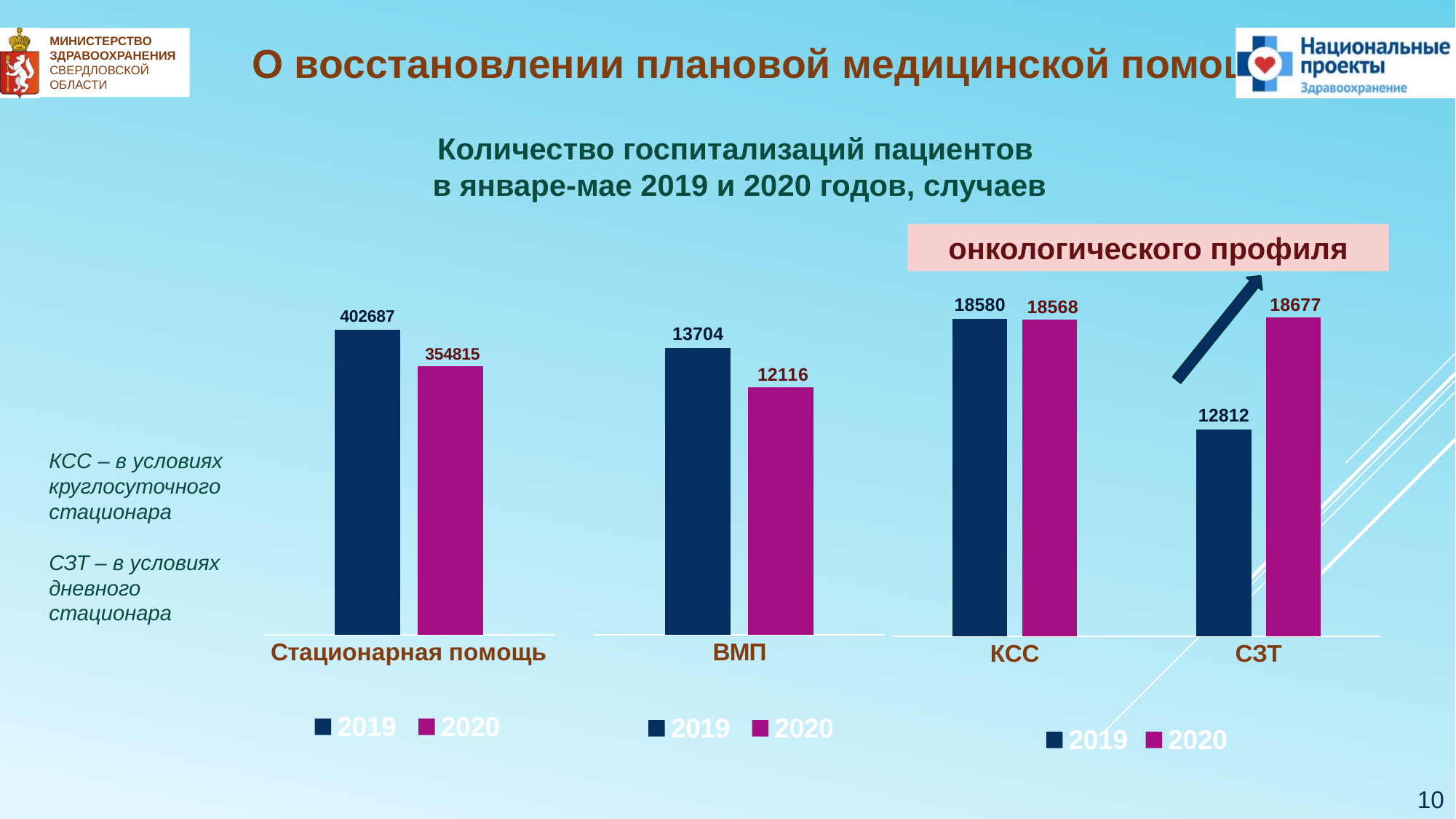
What type of chart is the middle chart (ВМП)? Bar chart In the left chart (Стационарная помощь), what is the value for 2019? 402687 In the middle chart (ВМП), what is the value for 2020? 12116 How many series does the legend of the right chart (онкологического профиля) list? 2 In the left chart (Стационарная помощь), what is the value for 2020? 354815 In the middle chart (ВМП), which year has the larger value, 2019 or 2020? 2019 In the middle chart (ВМП), what is the difference between the 2019 and 2020 values? 1588 In the right chart (онкологического профиля), what is the value for КСС in 2019? 18580 In the right chart (онкологического профиля), what is the difference between the 2020 and 2019 values for СЗТ? 5865 In the left chart (Стационарная помощь), what is the difference between the 2019 and 2020 values? 47872 In the right chart (онкологического профиля), which category has the lowest value across both years? СЗТ in 2019 In the right chart (онкологического профиля), what is the value for СЗТ in 2020? 18677